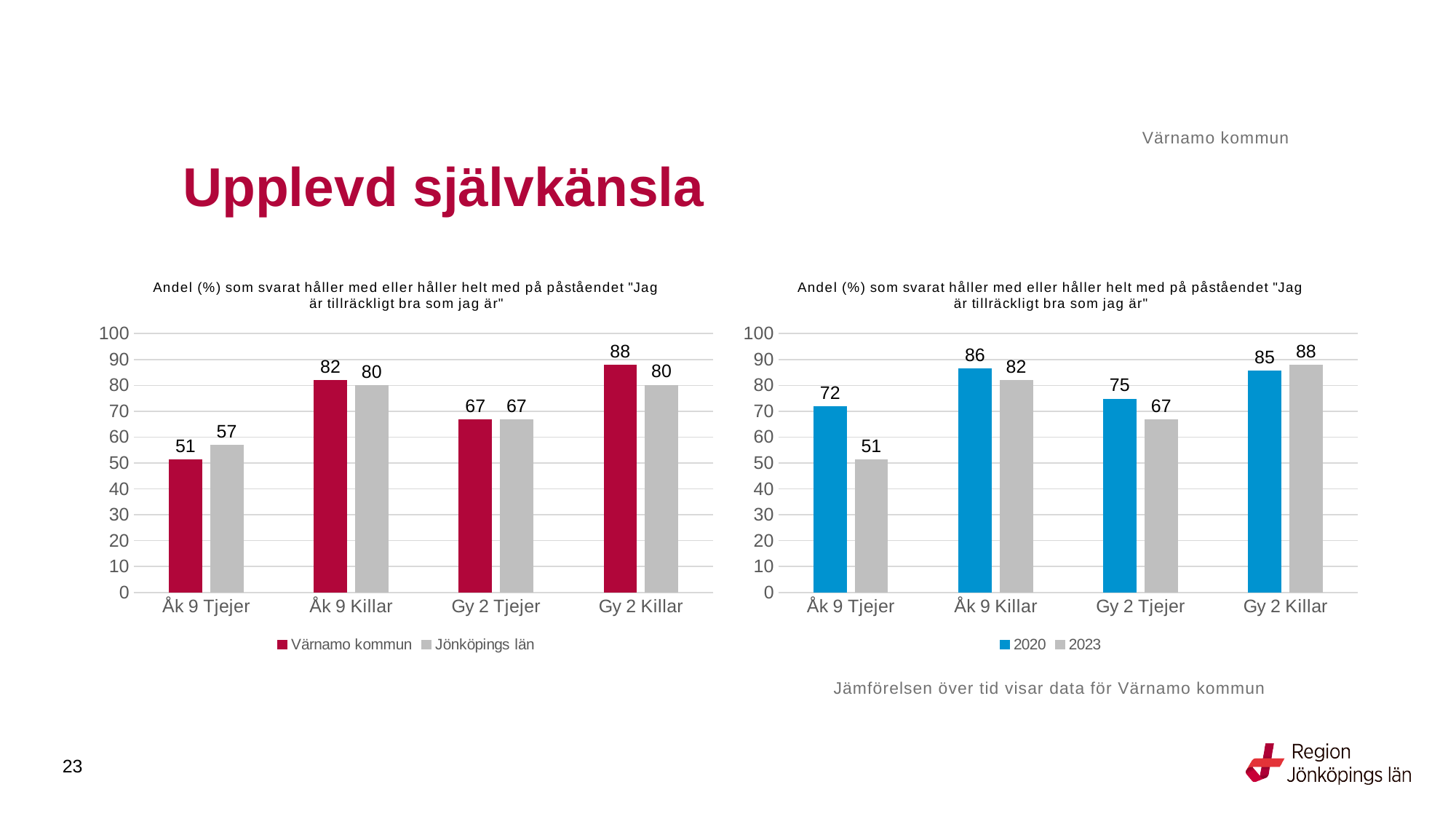
What kind of chart is the left chart? Bar chart In the right chart, which is larger for Gy 2 Killar: the 2020 value or the 2023 value? 2023 In the right chart, what is the value for 2023 for Åk 9 Tjejer? 51 In the right chart, which category has the lowest value for 2023? Åk 9 Tjejer In the left chart, what is the difference between Värnamo kommun and Jönköpings län for Gy 2 Killar? 8 In the right chart, what is the value for 2020 for Gy 2 Tjejer? 75 In the right chart, what is the difference between the 2020 and 2023 values for Åk 9 Tjejer? 21 How many series does the legend of the right chart list? 2 In the left chart, which category has the highest value for Värnamo kommun? Gy 2 Killar How many categories are shown on the x axis of the left chart? 4 In the left chart, what is the value for Värnamo kommun for Åk 9 Tjejer? 51 In the left chart, what is the value for Jönköpings län for Gy 2 Killar? 80